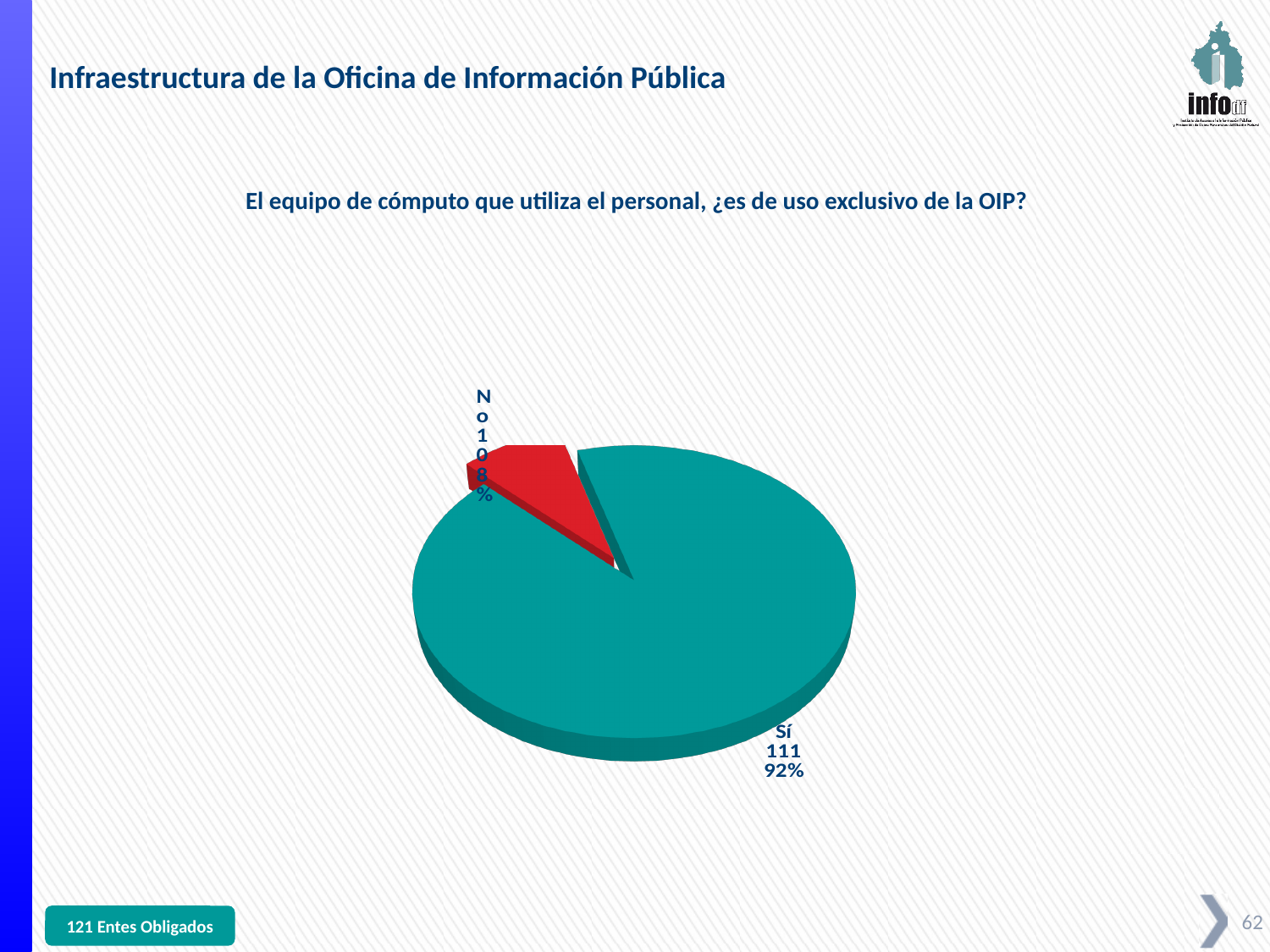
What is the total of the two slices in the pie chart? 121 Which slice is the largest? Sí Which slice is the smallest? No Which is larger, the "Sí" slice or the "No" slice? Sí What is the difference between the "Sí" and "No" values? 101 What is the value for the "Sí" slice? 111 What is the value for the "No" slice? 10 What share of the pie does the "Sí" slice represent? 92% What share of the pie does the "No" slice represent? 8% How many slices does the pie chart have? 2 What kind of chart is shown on the slide? pie chart What colour is the "No" slice? red